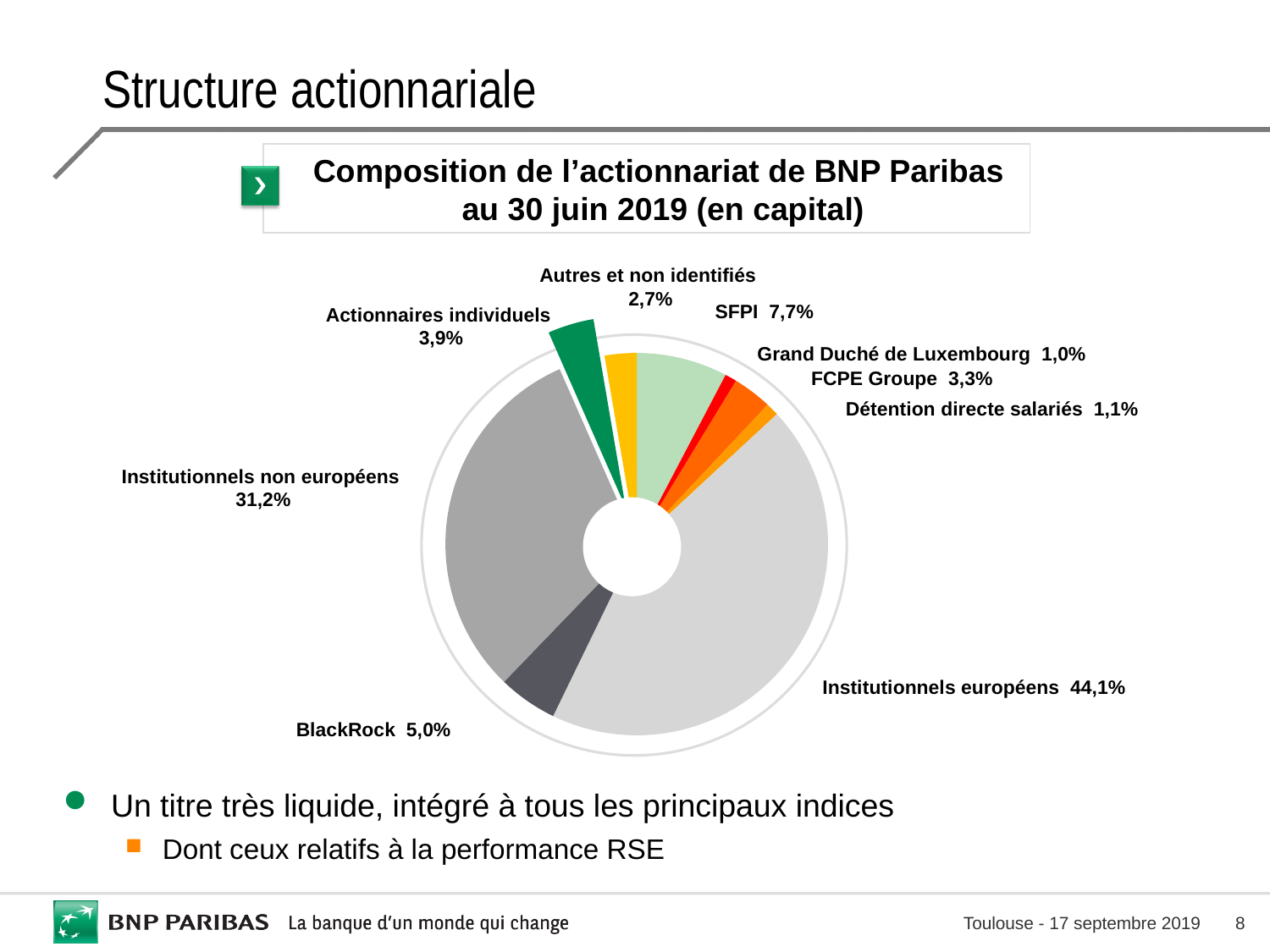
What is the title of the chart? Composition de l'actionnariat de BNP Paribas au 30 juin 2019 (en capital) Which shareholder category holds the smallest share of capital? Grand Duché de Luxembourg What share of capital does SFPI hold? 7,7% What kind of chart is shown on the slide? Pie chart Which holds a larger share of capital, SFPI or BlackRock? SFPI Which shareholder category holds the largest share of capital? Institutionnels européens How many shareholder categories are shown in the chart? 9 What is the share held by BlackRock? 5,0% What share of BNP Paribas capital is held by Institutionnels européens? 44,1% What is the share for FCPE Groupe? 3,3% What share of capital is held by Institutionnels non européens? 31,2% What is the difference between the shares of Institutionnels européens and Institutionnels non européens? 12,9%